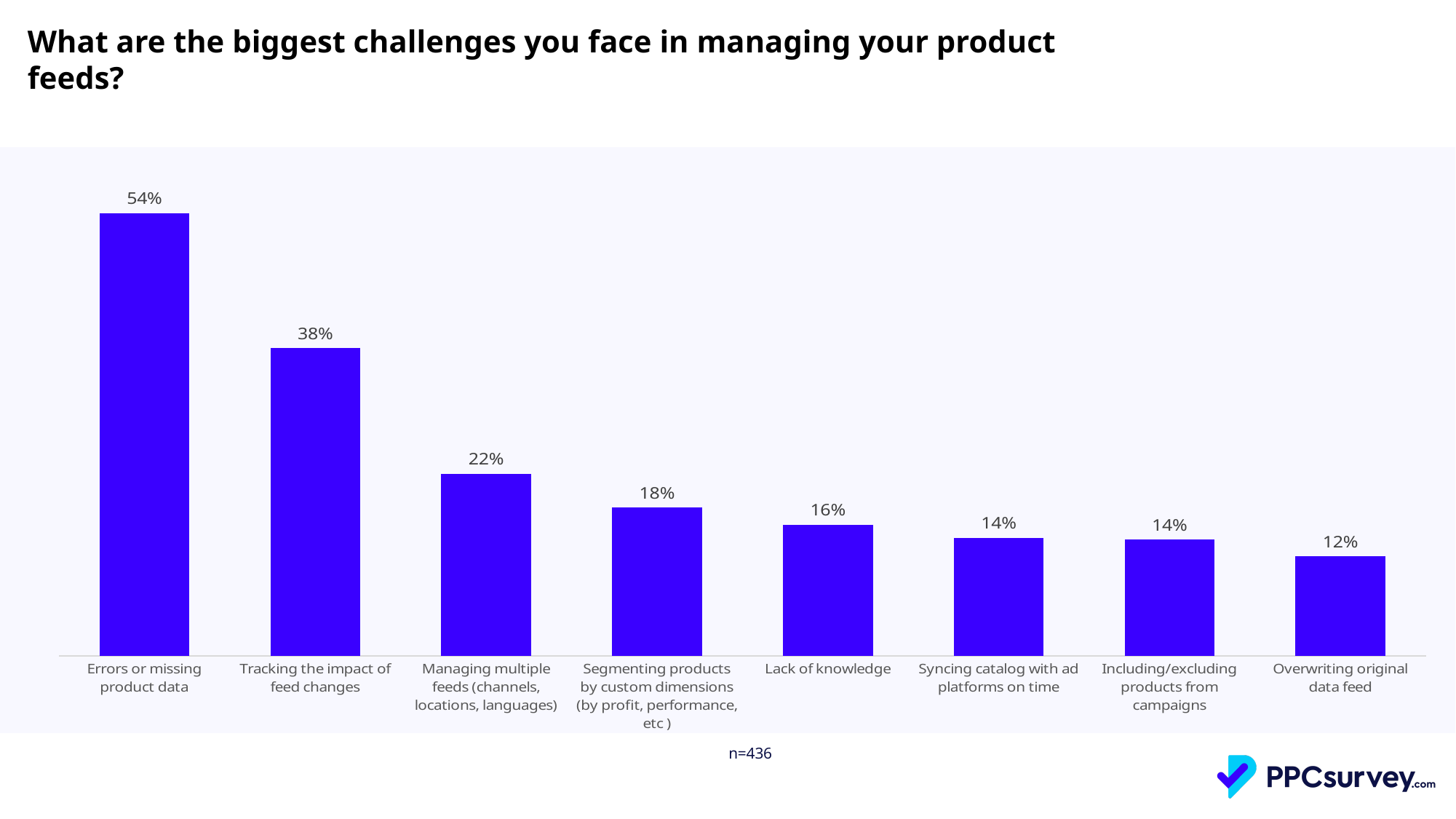
How many challenge categories are shown in the chart? 8 Which is larger: 'Lack of knowledge' or 'Syncing catalog with ad platforms on time'? Lack of knowledge What is the sample size (n) noted below the chart? n=436 What is the difference between 'Managing multiple feeds (channels, locations, languages)' and 'Segmenting products by custom dimensions (by profit, performance, etc )'? 4% What percentage of respondents cited 'Errors or missing product data' as a challenge? 54% What type of chart is shown on the slide? Bar chart What is the value for 'Lack of knowledge'? 16% What is the value for 'Tracking the impact of feed changes'? 38% Which challenge has the highest percentage? Errors or missing product data What is the value for 'Overwriting original data feed'? 12% What is the difference between 'Errors or missing product data' and 'Tracking the impact of feed changes'? 16% Which challenge has the lowest percentage? Overwriting original data feed